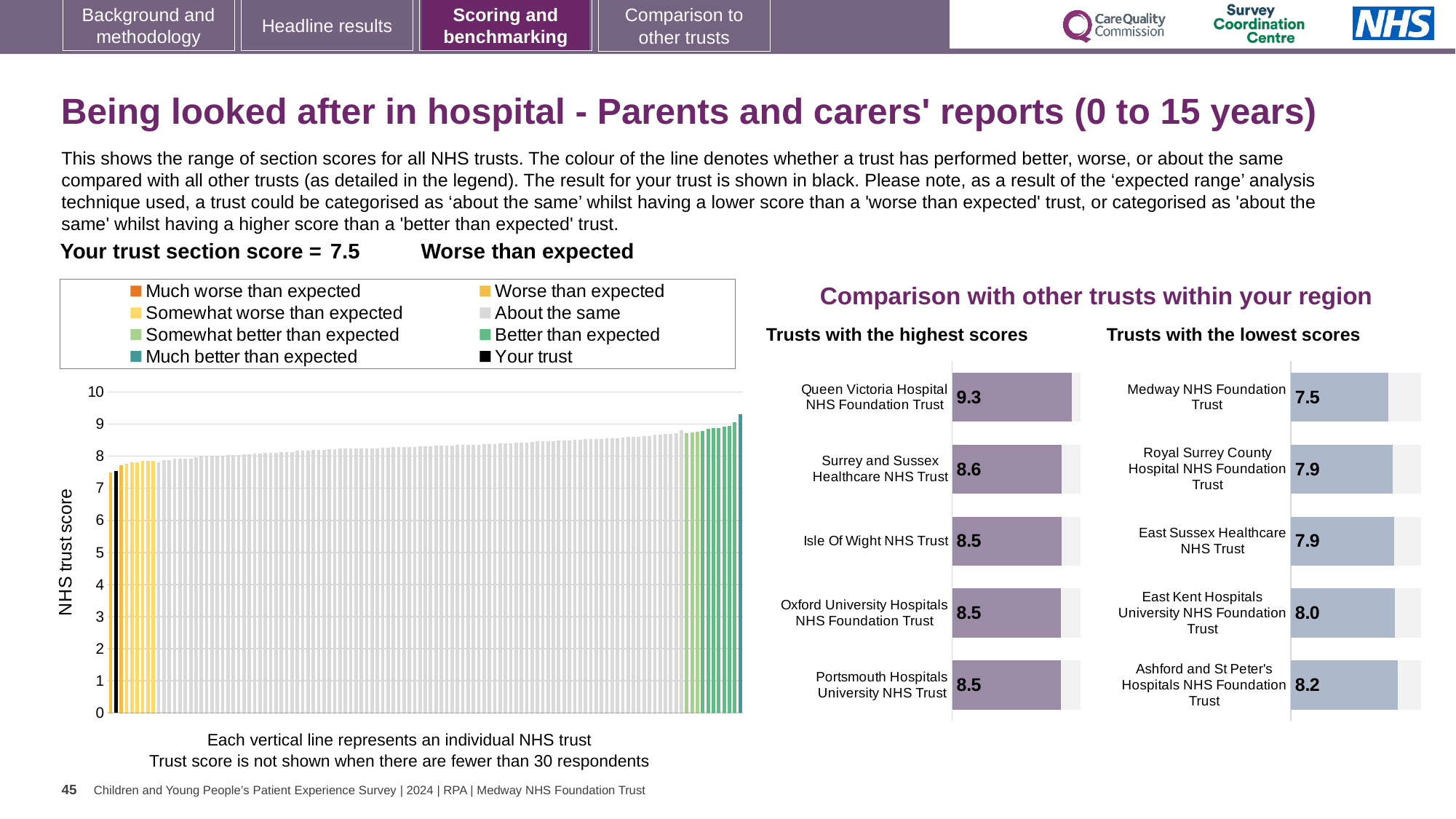
In the 'Trusts with the highest scores' chart, what is the difference between the scores of Queen Victoria Hospital NHS Foundation Trust and Surrey and Sussex Healthcare NHS Trust? 0.7 How many trusts are shown in the 'Trusts with the highest scores' chart? 5 What kind of chart is the large chart on the left showing NHS trust scores? Bar chart In the 'Trusts with the highest scores' chart, what is the score for Isle Of Wight NHS Trust? 8.5 In the large chart on the left, do the trust scores rise or fall from left to right? Rise In the 'Trusts with the highest scores' chart, which trust has the highest score? Queen Victoria Hospital NHS Foundation Trust How many entries does the legend of the large chart on the left list? 8 In the 'Trusts with the lowest scores' chart, what is the difference between the scores of Ashford and St Peter's Hospitals NHS Foundation Trust and Medway NHS Foundation Trust? 0.7 In the 'Trusts with the lowest scores' chart, what is the score for Medway NHS Foundation Trust? 7.5 In the 'Trusts with the lowest scores' chart, which trust has the lowest score? Medway NHS Foundation Trust In the 'Trusts with the highest scores' chart, what is the score for Queen Victoria Hospital NHS Foundation Trust? 9.3 In the 'Trusts with the lowest scores' chart, which has the higher score: East Kent Hospitals University NHS Foundation Trust or Royal Surrey County Hospital NHS Foundation Trust? East Kent Hospitals University NHS Foundation Trust